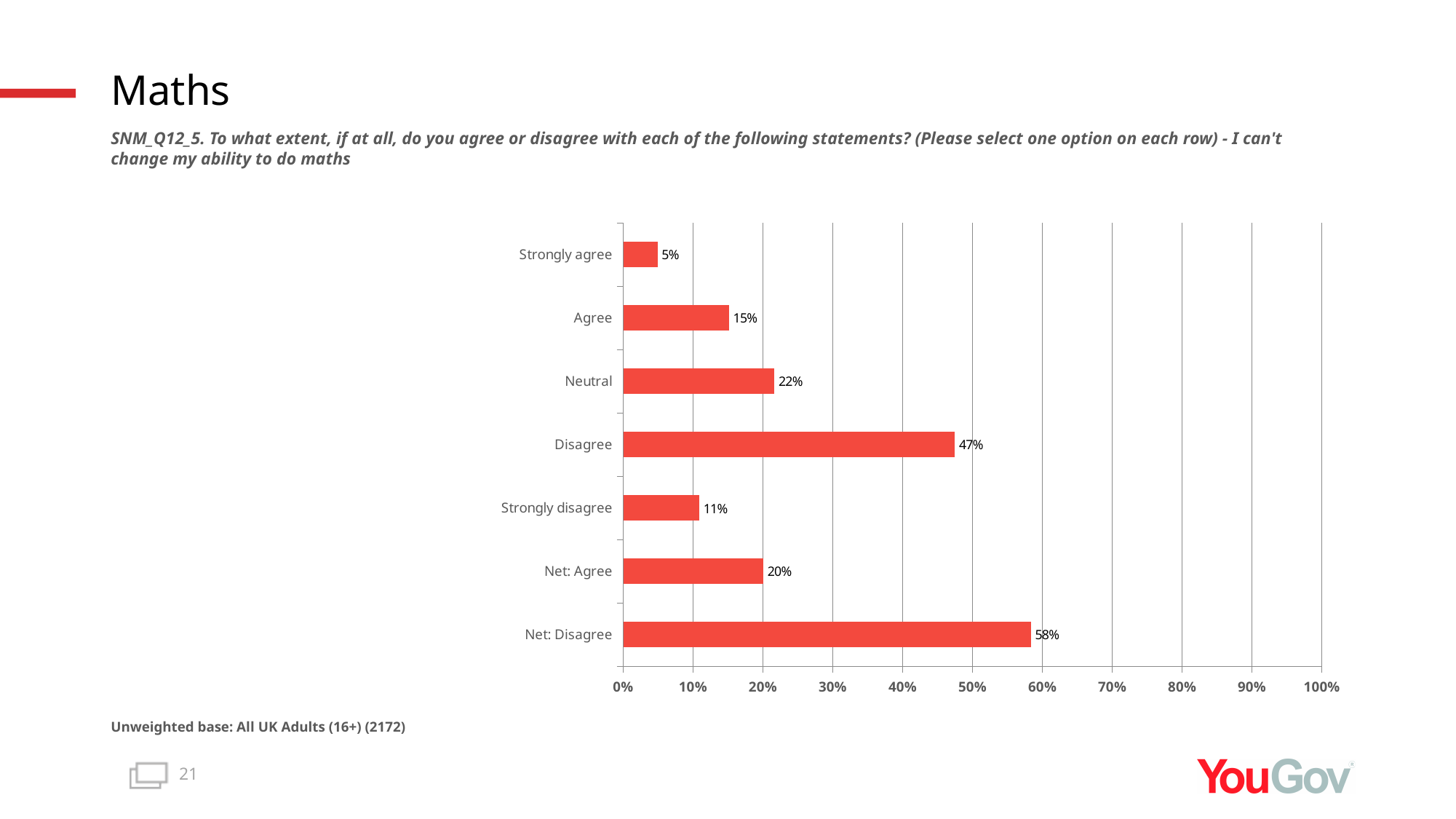
What kind of chart is shown on the slide? Bar chart What is the value for 'Net: Disagree'? 58% What is the difference between 'Net: Disagree' and 'Net: Agree'? 38% What percentage of respondents selected 'Disagree'? 47% Which category has the highest value? Net: Disagree Is the value for 'Disagree' greater or less than 40%? greater What is the difference between 'Disagree' and 'Strongly disagree'? 36% How many categories are shown on the chart? 7 What is the unweighted base stated on the slide? All UK Adults (16+) (2172) Which category has the lowest value? Strongly agree What is the value shown for 'Strongly agree'? 5% Which is larger, the value for 'Neutral' or the value for 'Agree'? Neutral